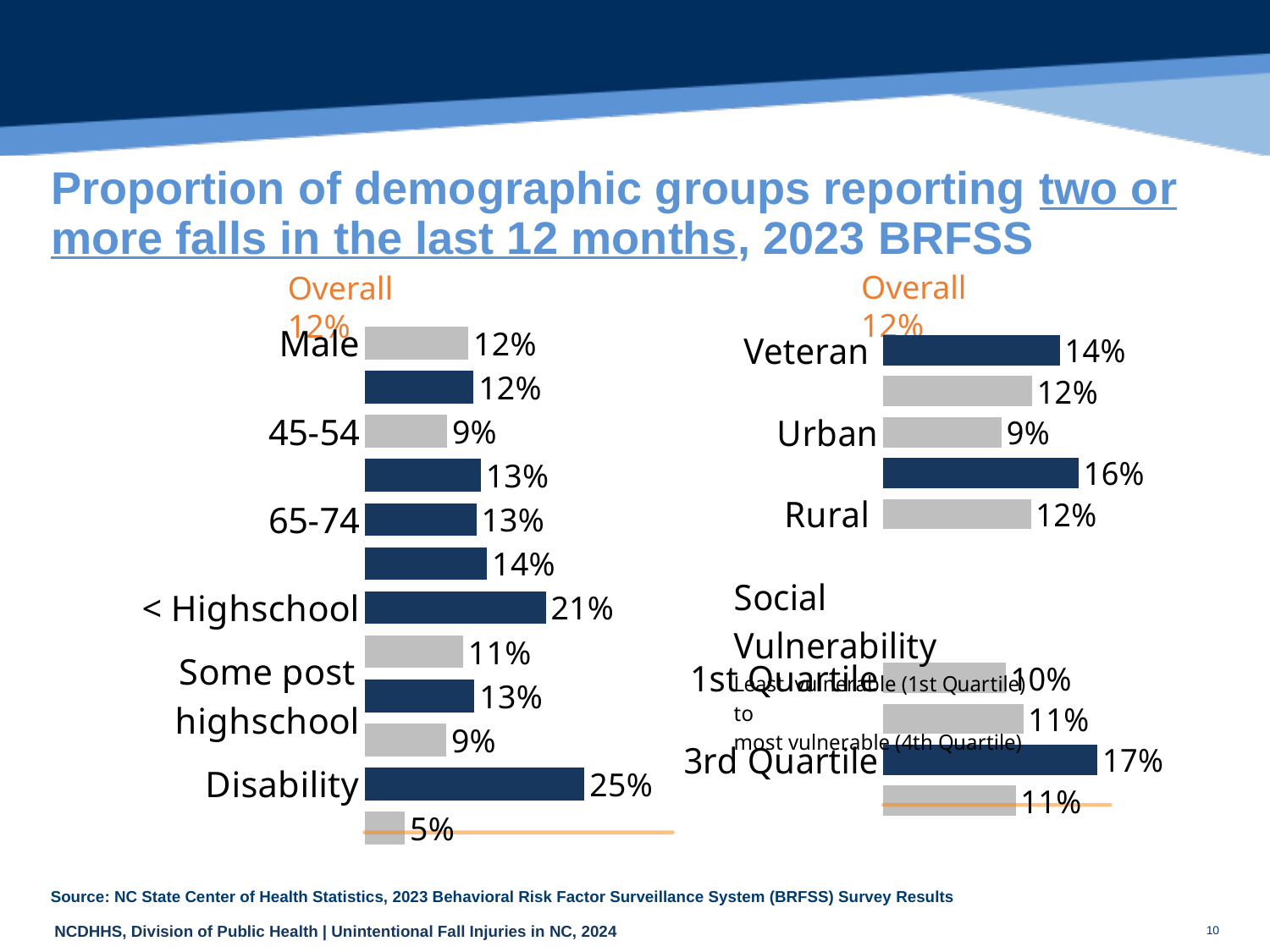
On the right chart, what percentage is shown for 3rd Quartile? 17% On the right chart, which labeled category has the lowest value? Urban On the left chart, which labeled category has the highest value? Disability On the left chart, what percentage is shown for the 45-54 age group? 9% On the left chart, what percentage is shown for Disability? 25% On the left chart, what is the difference between the Disability value and the Male value? 13% On the right chart, what percentage is shown for Veteran? 14% What type of chart is used on this slide? Bar chart On the right chart, what is the difference between the 3rd Quartile value and the 1st Quartile value? 7% On the left chart, what percentage is shown for < Highschool? 21% What Overall value is marked as the reference on both charts? 12% On the right chart, which is larger, the value for Rural or the value for Urban? Rural